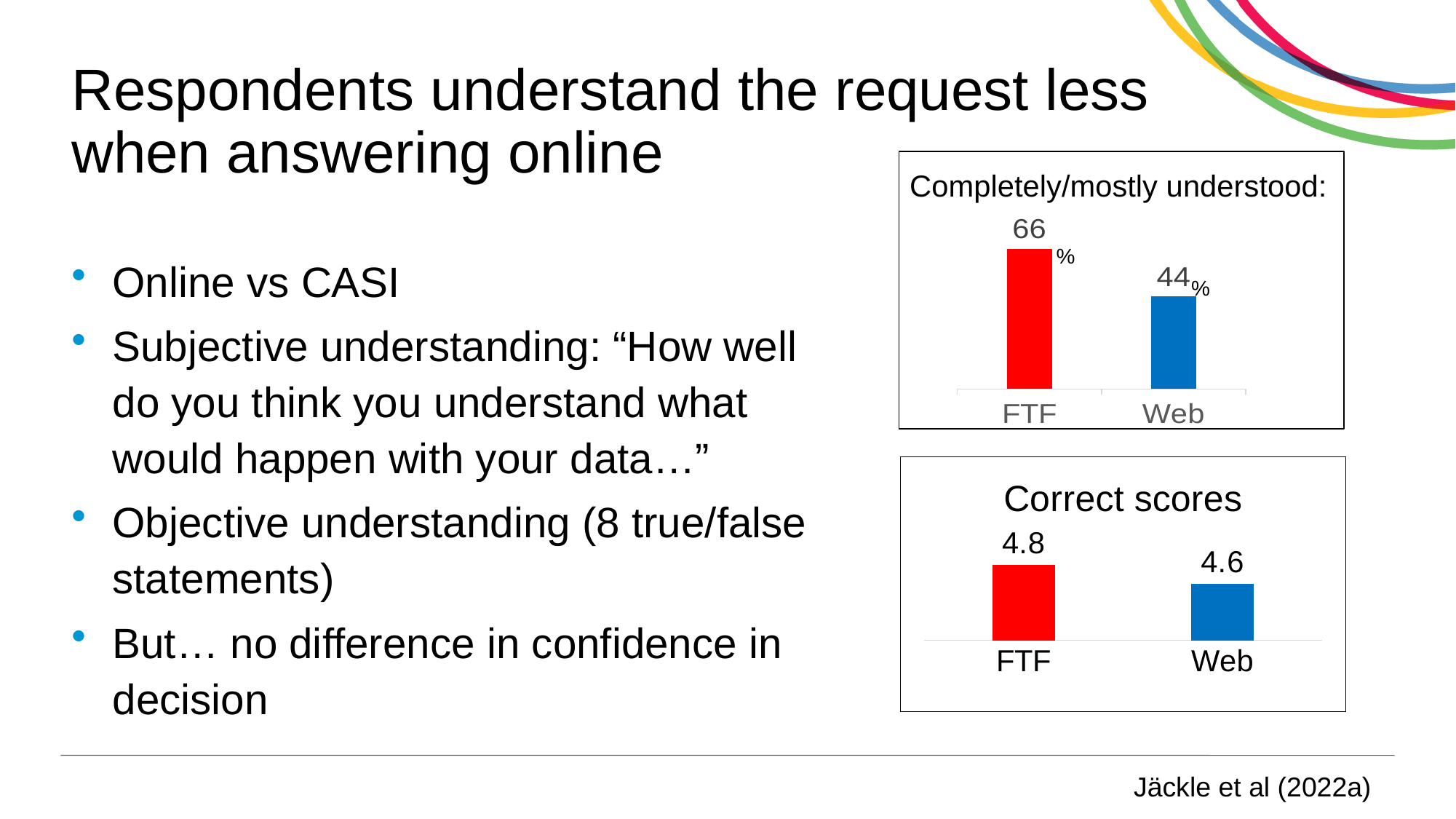
How many categories are shown in the 'Completely/mostly understood' chart? 2 In the 'Completely/mostly understood' chart, what colour is the Web bar? blue In the 'Correct scores' chart, what is the value for Web? 4.6 In the 'Correct scores' chart, what is the value for FTF? 4.8 In the 'Completely/mostly understood' chart, which category has the higher value? FTF In the 'Correct scores' chart, is the value for FTF larger or smaller than the value for Web? larger In the 'Correct scores' chart, what is the difference between the FTF and Web scores? 0.2 What type of chart is the 'Correct scores' chart? bar chart In the 'Correct scores' chart, which category has the lower value? Web In the 'Completely/mostly understood' chart, what is the value for Web? 44% In the 'Completely/mostly understood' chart, what is the difference between the FTF and Web values? 22% In the 'Completely/mostly understood' chart, what is the value for FTF? 66%